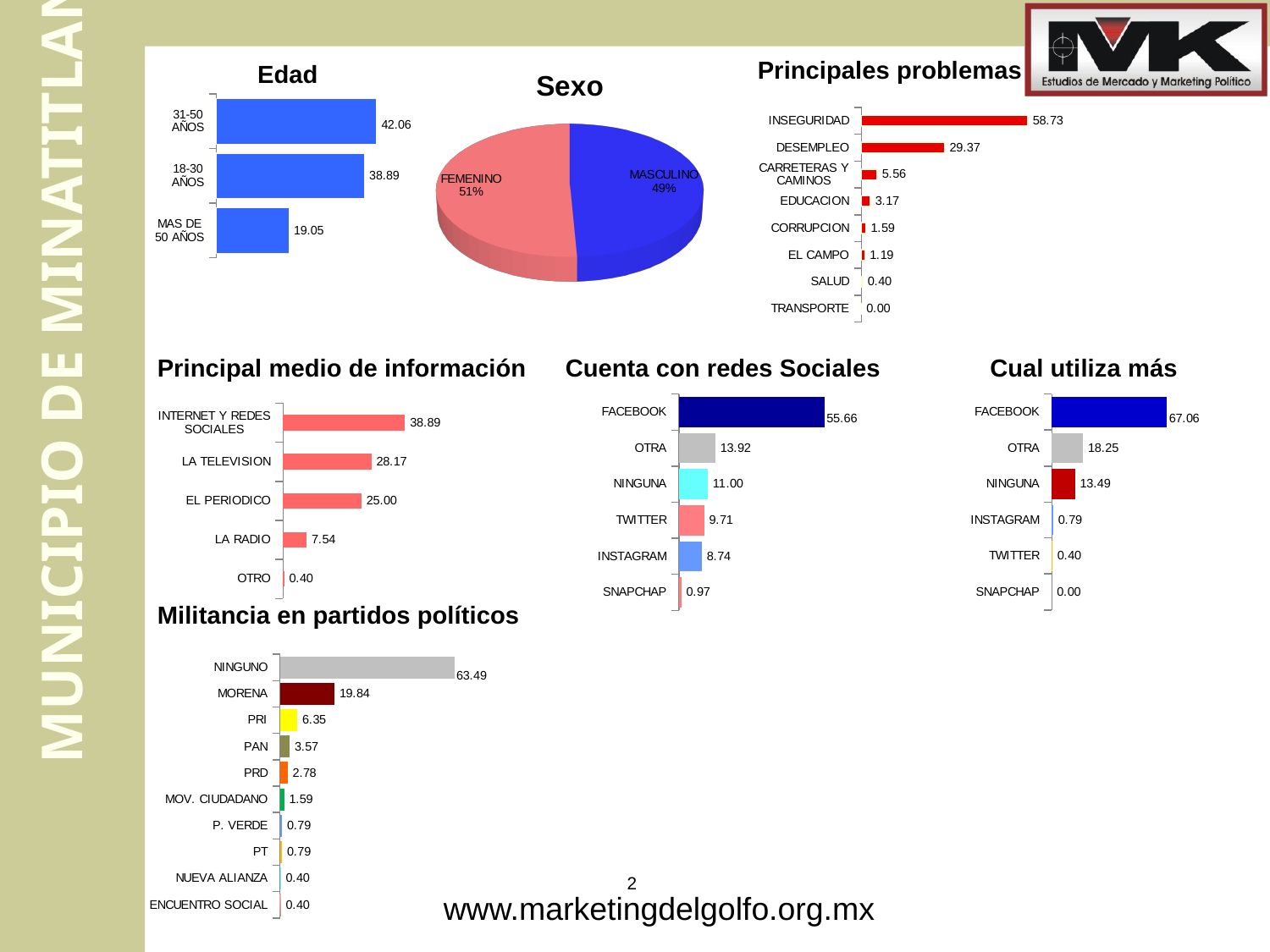
In the 'Principal medio de información' chart, what is the value for LA TELEVISION? 28.17 In the 'Militancia en partidos políticos' chart, what is the value for MORENA? 19.84 In the 'Edad' chart, what is the value for 31-50 AÑOS? 42.06 In the 'Militancia en partidos políticos' chart, how many categories are shown? 10 In the 'Principales problemas' chart, how many categories are shown? 8 In the 'Principales problemas' chart, what is the difference between INSEGURIDAD and DESEMPLEO? 29.36 In the 'Cuenta con redes Sociales' chart, which is larger, TWITTER or INSTAGRAM? TWITTER In the 'Sexo' pie chart, what share does FEMENINO have? 51% In the 'Principales problemas' chart, which category has the highest value? INSEGURIDAD In the 'Cual utiliza más' chart, what is the value for FACEBOOK? 67.06 In the 'Principal medio de información' chart, which category has the lowest value? OTRO What kind of chart is the 'Sexo' chart? Pie chart